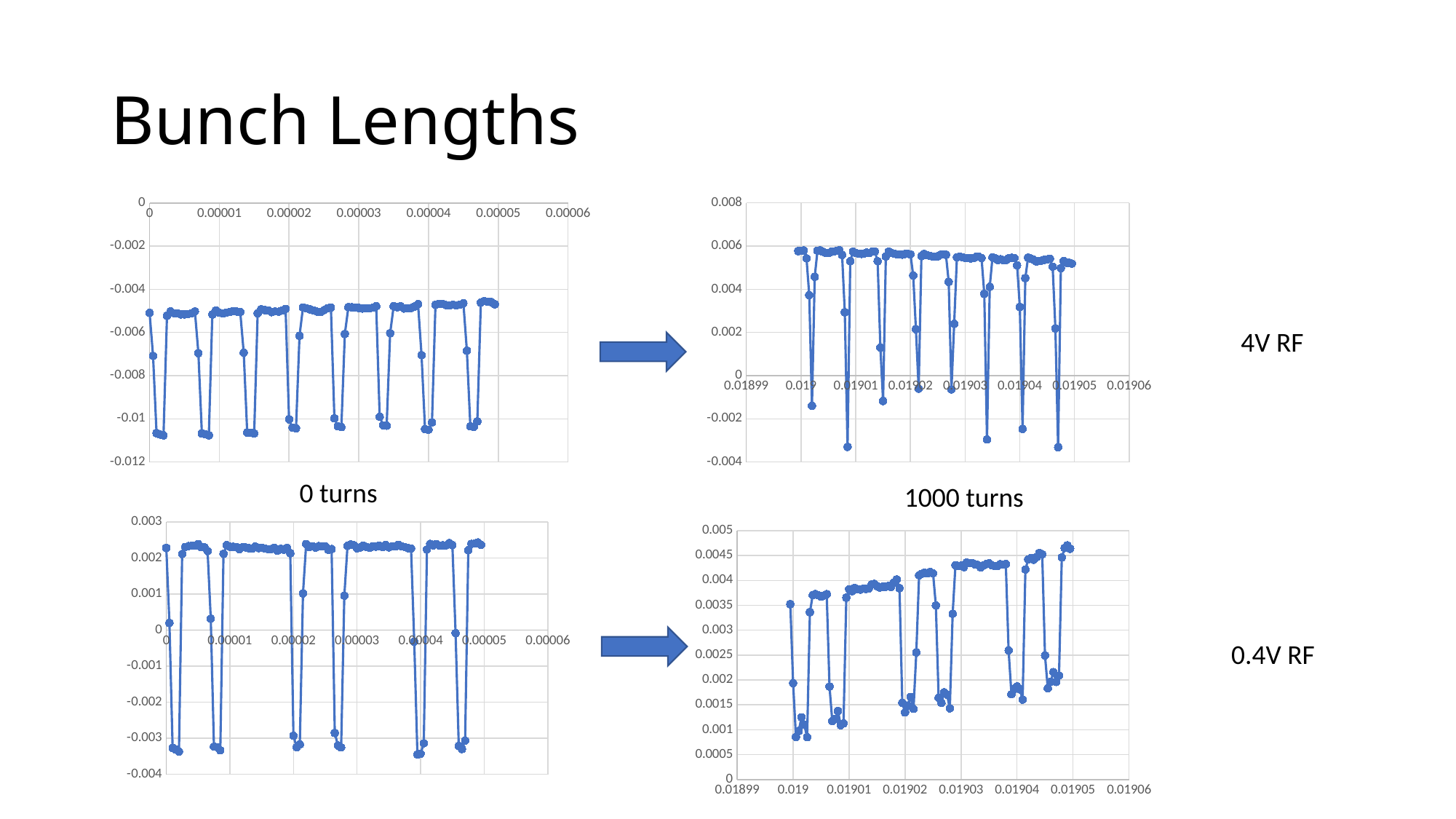
In the bottom-right chart (1000 turns, 0.4V RF), do the plateau values rise or fall as x increases? rise In the top-right chart (1000 turns, 4V RF), are the lowest dip points greater or less than -0.002? less In the bottom-left chart (0 turns, 0.4V RF), are the plateau values greater or less than 0.002? greater In the top-left chart (0 turns, 4V RF), are the plateau values between the dips greater or less than -0.004? less In the top-right chart (1000 turns, 4V RF), do the plateau values rise or fall as x increases? fall What is the maximum value shown on the y axis of the top-right chart (1000 turns, 4V RF)? 0.008 What is the minimum value shown on the y axis of the top-left chart (0 turns, 4V RF)? -0.012 What kind of chart is the top-left chart (0 turns, 4V RF)? line chart